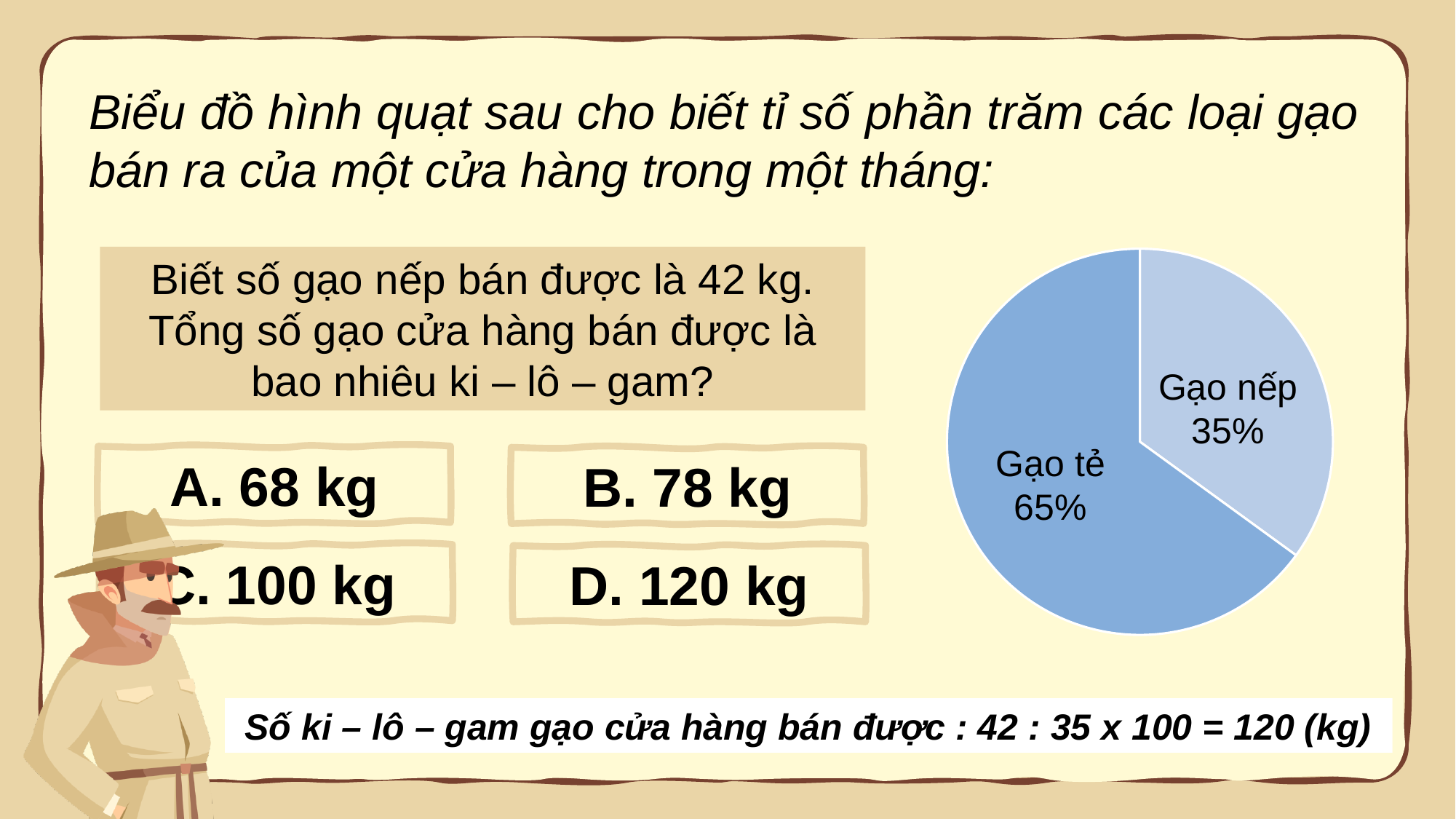
Which is larger in the pie chart, Gạo nếp or Gạo tẻ? Gạo tẻ How many slices does the pie chart have? 2 Which category has the largest share of the pie chart? Gạo tẻ What is the total of the two percentages shown in the pie chart? 100% Is the share for Gạo tẻ greater or less than 50%? greater Which category has the smallest share of the pie chart? Gạo nếp Which slice of the pie chart is the darker blue? Gạo tẻ What percentage does the pie chart show for Gạo nếp? 35% What percentage does the pie chart show for Gạo tẻ? 65% What kind of chart is shown on the slide? pie chart What share of the pie does the Gạo nếp slice represent? 35% What is the difference in percentage points between Gạo tẻ and Gạo nếp? 30%